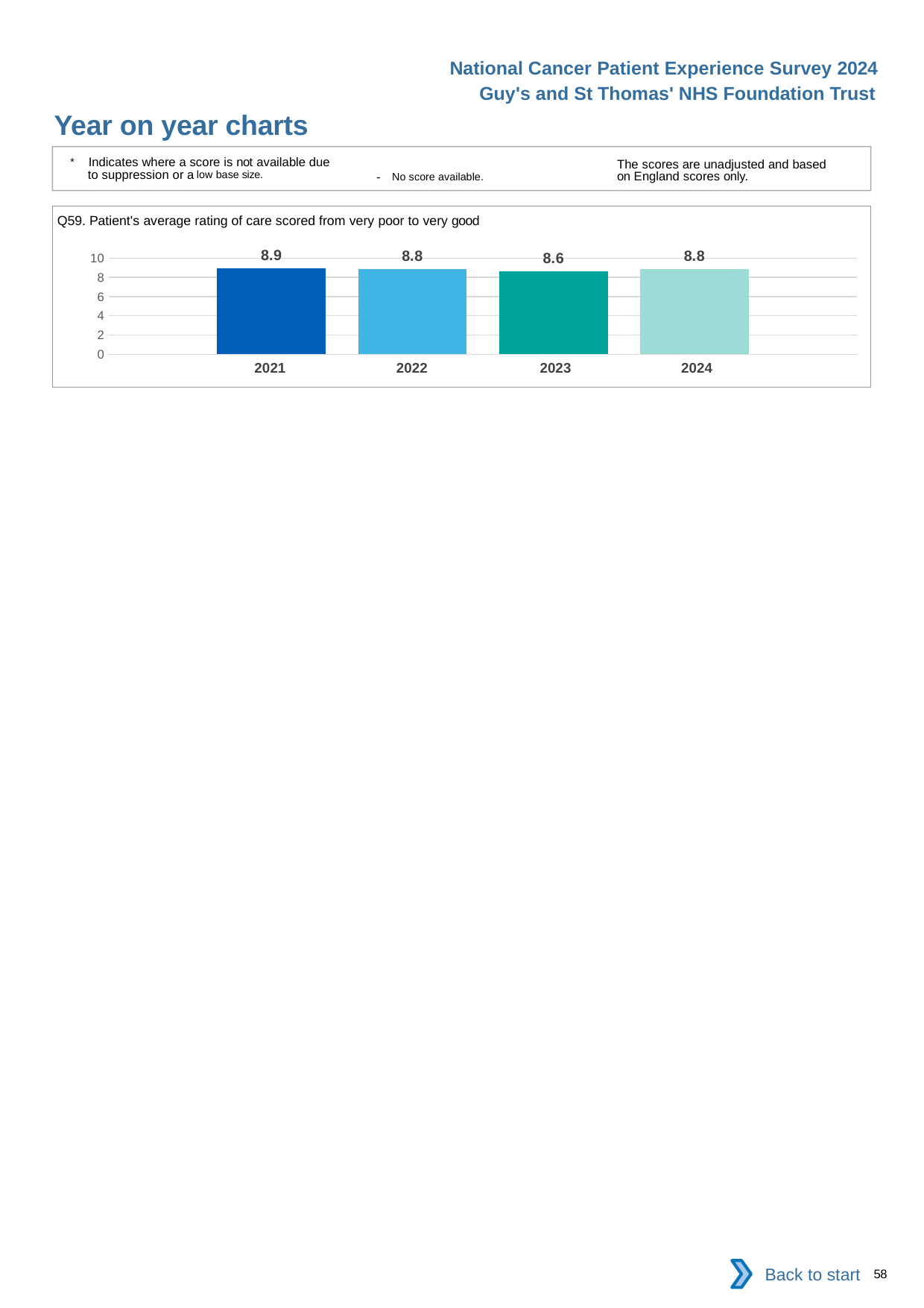
What is the title of the chart? Q59. Patient's average rating of care scored from very poor to very good Which is larger, the value for 2022 or the value for 2023? 2022 Which year has the lowest value? 2023 What kind of chart is shown? bar chart Is the value for 2023 greater or less than 8? greater What is the difference between the values for 2021 and 2023? 0.3 How many years are shown on the chart? 4 What is the value for 2024? 8.8 What is the value for 2023? 8.6 What is the value for 2021? 8.9 Which year has the highest value? 2021 Does the value rise or fall from 2021 to 2023? fall